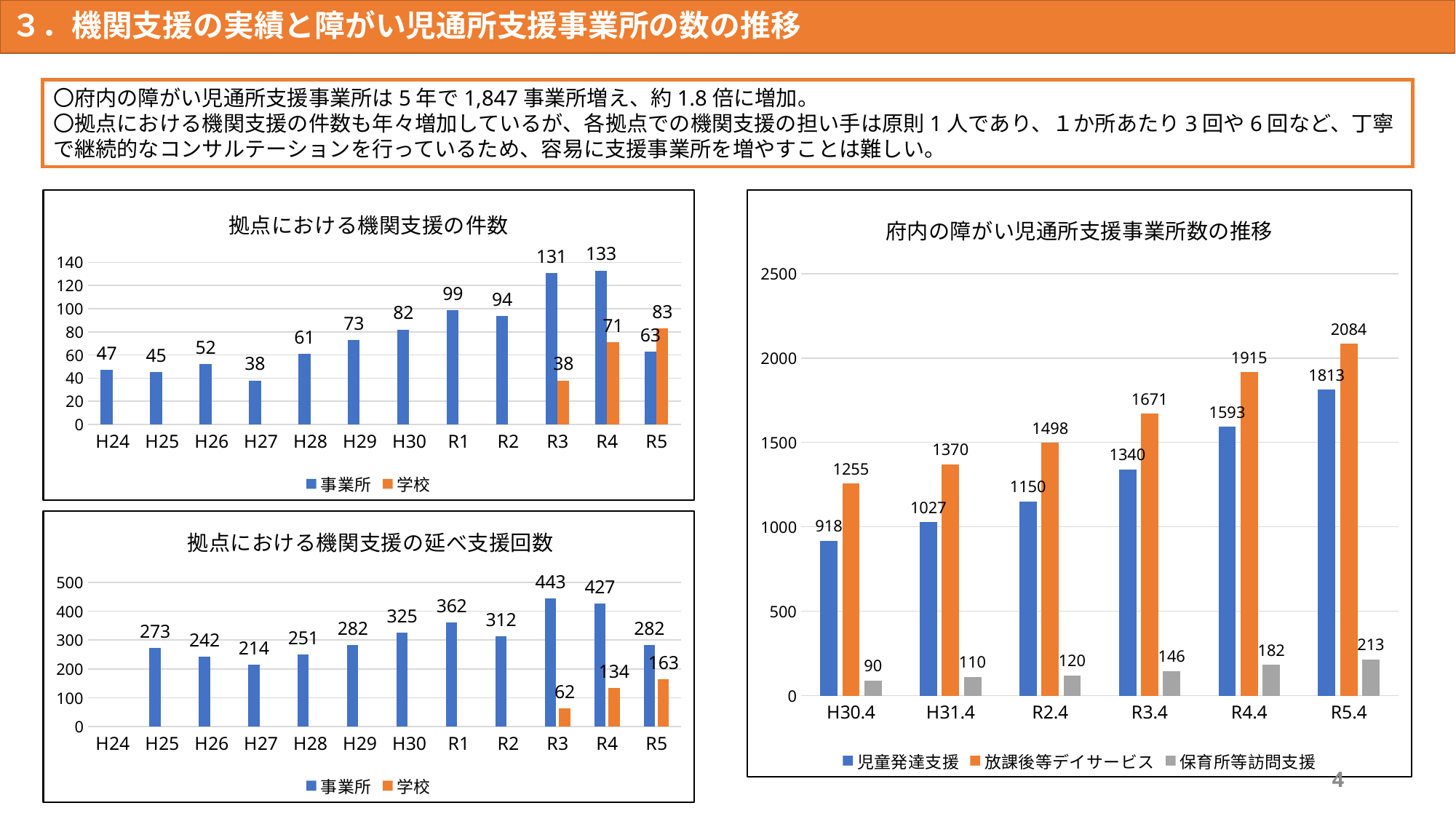
In the chart titled 拠点における機関支援の件数, which year has the lowest value for 事業所? H27 In the chart titled 府内の障がい児通所支援事業所数の推移, what is the value for 放課後等デイサービス in R5.4? 2084 In the chart titled 拠点における機関支援の延べ支援回数, what is the value for 事業所 in R3? 443 In the chart titled 拠点における機関支援の件数, what is the difference between the 学校 values for R5 and R3? 45 In the chart titled 拠点における機関支援の延べ支援回数, which is larger, the 事業所 value for R5 or the 学校 value for R5? 事業所 In the chart titled 拠点における機関支援の延べ支援回数, which year has the highest value for 事業所? R3 In the chart titled 拠点における機関支援の件数, what is the value for 事業所 in R4? 133 In the chart titled 拠点における機関支援の延べ支援回数, how many categories are shown on the x axis? 12 What kind of chart is the chart titled 府内の障がい児通所支援事業所数の推移? bar chart In the chart titled 府内の障がい児通所支援事業所数の推移, does the value for 保育所等訪問支援 rise or fall from H30.4 to R5.4? rise In the chart titled 府内の障がい児通所支援事業所数の推移, what is the difference between the 児童発達支援 values for R5.4 and H30.4? 895 In the chart titled 拠点における機関支援の件数, how many series does the legend list? 2